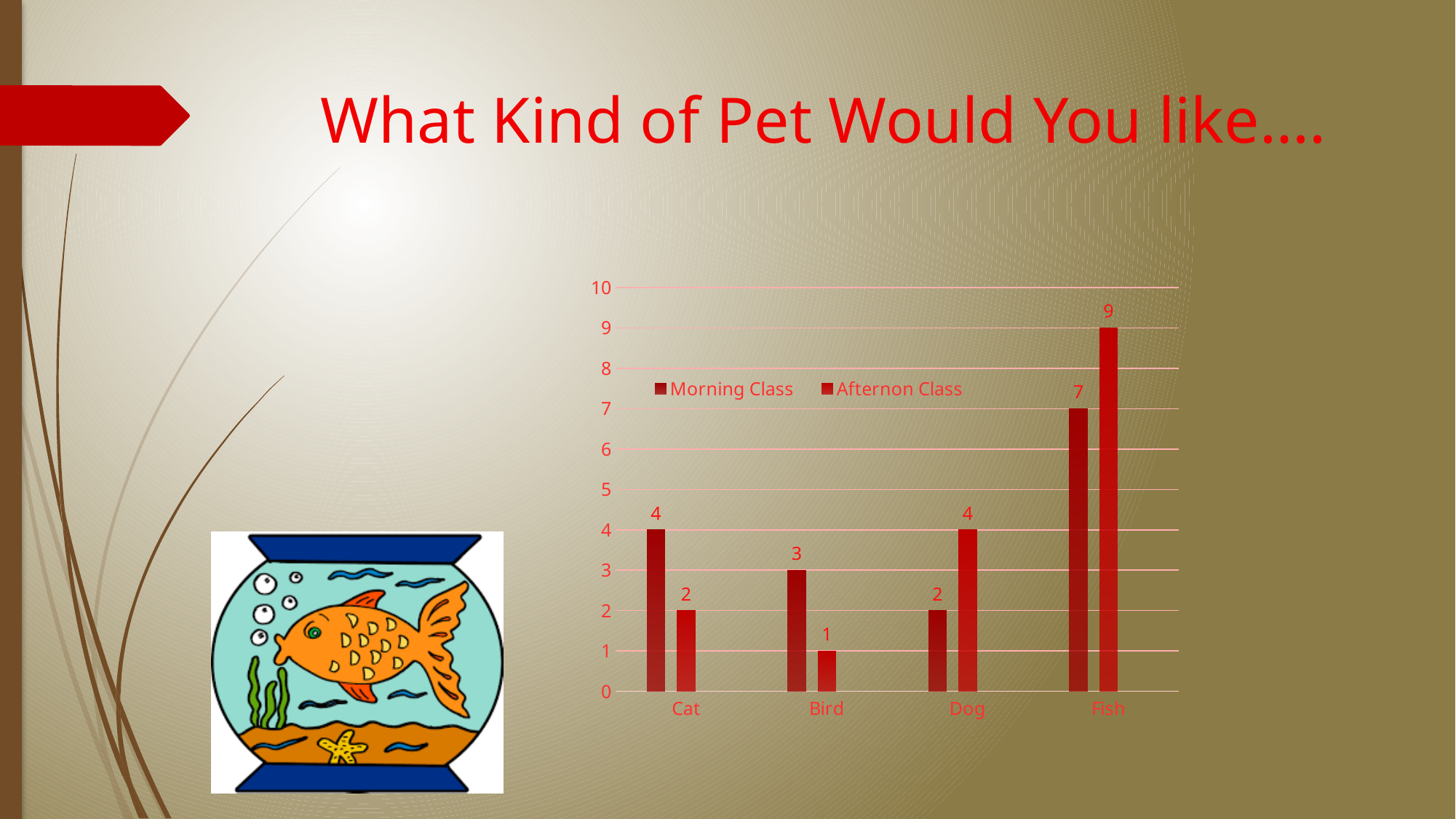
How many series does the legend list? 2 What is the Afternon Class value for Fish? 9 What is the difference between the Afternon Class and Morning Class values for Fish? 2 Which pet has the highest Morning Class value? Fish Which pet has the lowest Afternon Class value? Bird What are the two series names listed in the legend? Morning Class and Afternon Class What is the Morning Class value for Cat? 4 What is the Morning Class value for Bird? 3 What is the Afternon Class value for Dog? 4 How many pet categories are shown on the x axis? 4 For Dog, which is larger: the Morning Class value or the Afternon Class value? Afternon Class What kind of chart is shown on the slide? Bar chart